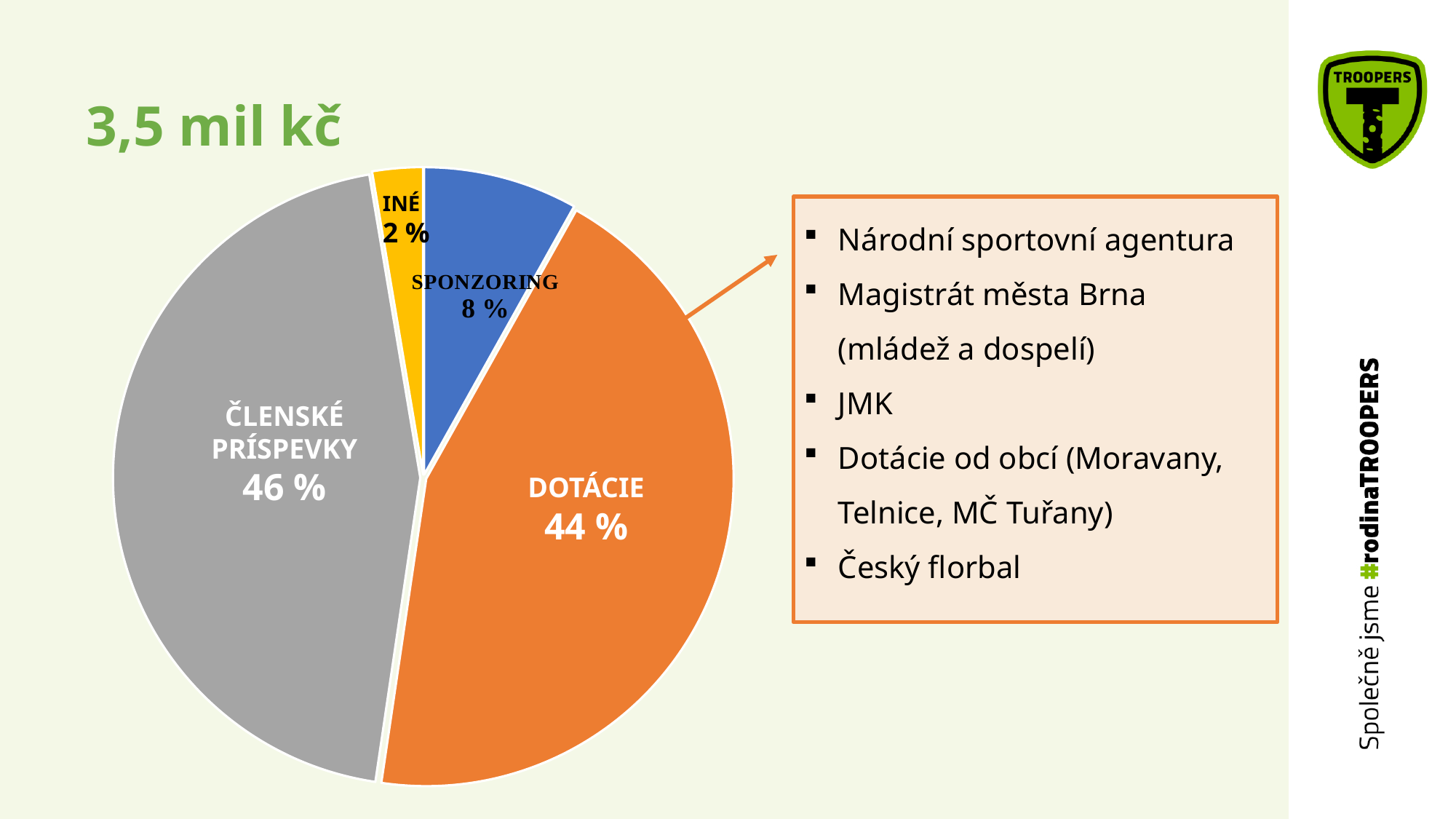
Which slice of the pie is the smallest? INÉ What is the difference in percentage points between SPONZORING and INÉ? 6 % Which is larger, the share for DOTÁCIE or the share for SPONZORING? DOTÁCIE What kind of chart is shown on the slide? Pie chart What is the difference in percentage points between ČLENSKÉ PRÍSPEVKY and DOTÁCIE? 2 % What share of the pie does ČLENSKÉ PRÍSPEVKY represent? 46 % What share of the pie does SPONZORING represent? 8 % How many slices does the pie chart have? 4 What share of the pie does INÉ represent? 2 % Which slice of the pie is the largest? ČLENSKÉ PRÍSPEVKY What colour is the DOTÁCIE slice? Orange